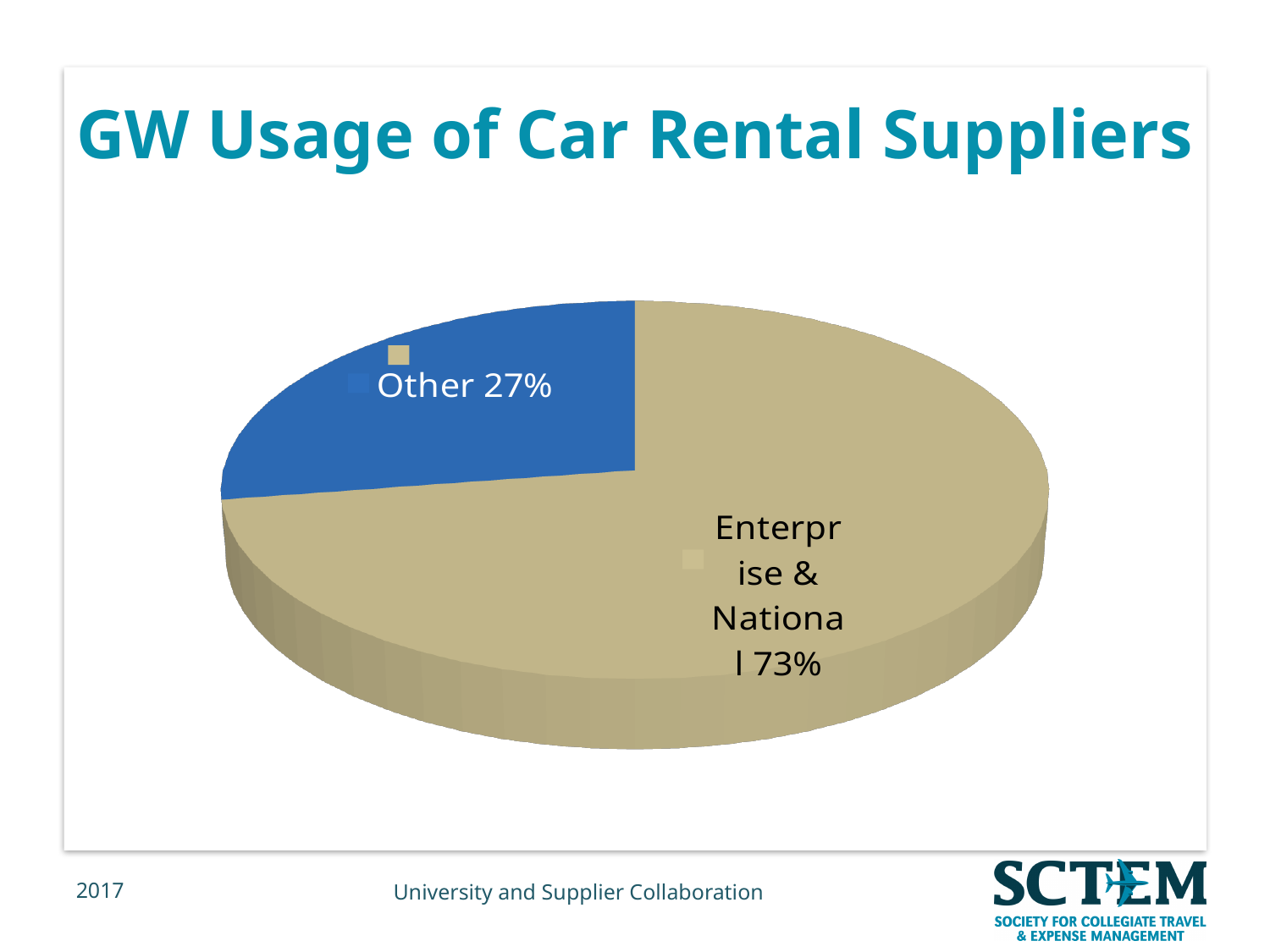
Which is larger, the Enterprise & National slice or the Other slice? Enterprise & National How many slices does the pie chart have? 2 What is the title of the chart on the slide? GW Usage of Car Rental Suppliers Which slice of the pie is the smallest? Other What kind of chart is shown on the slide? pie chart What colour is the Other slice of the pie? blue What share of the pie does Other account for? 27% What is the difference in percentage points between the Enterprise & National slice and the Other slice? 46 Which slice of the pie is the largest? Enterprise & National What share of the pie does Enterprise & National account for? 73%